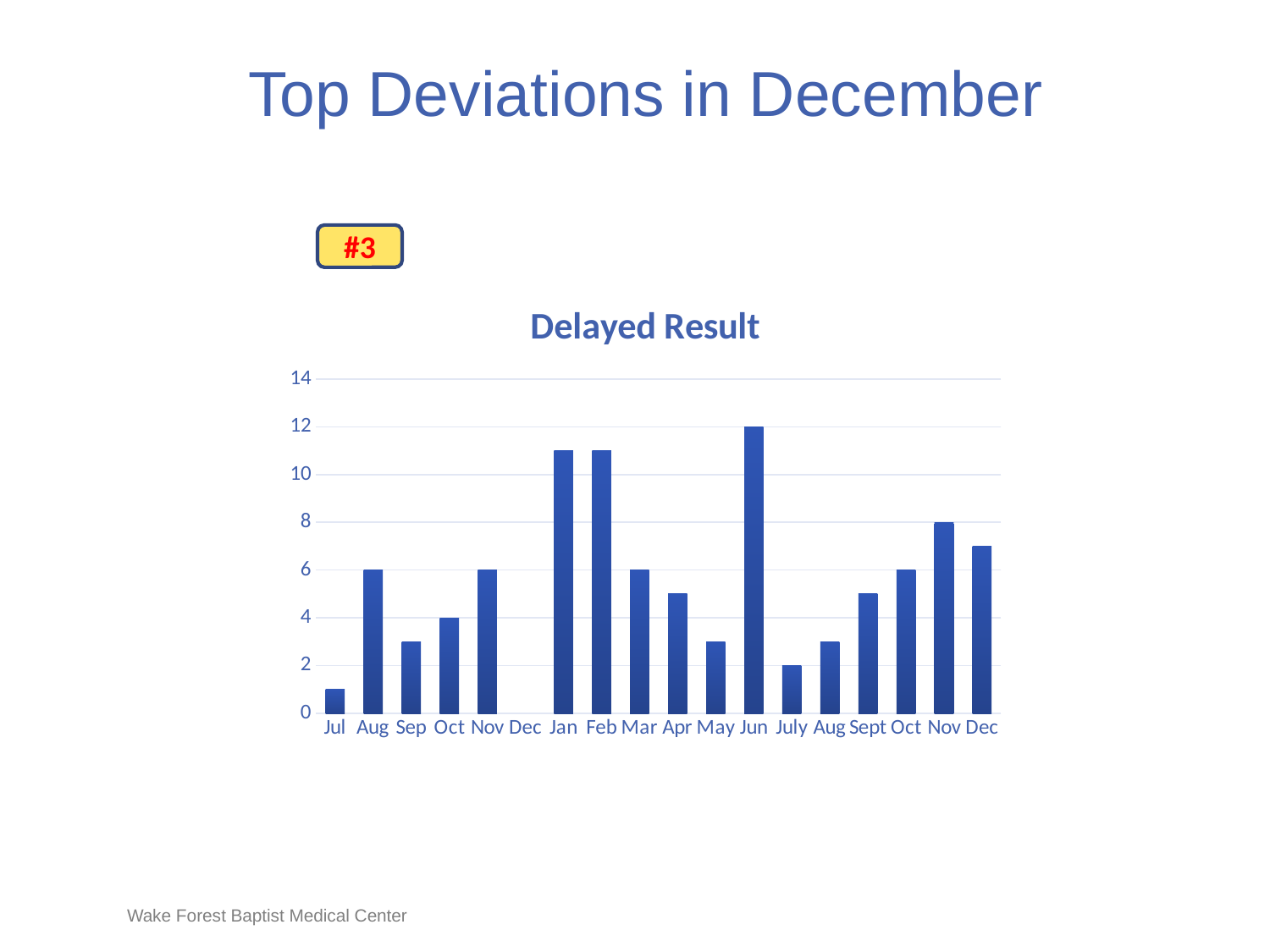
What is the value for the second Nov on the x axis? 8 What is the value for July? 2 What is the value for Jun? 12 What is the difference between the value for Jun and the value for the second Nov? 4 What type of chart is shown on the slide? bar chart Which month has the highest value in the chart? Jun What is the value for the first Oct on the x axis? 4 How many months are shown along the x axis of the chart? 18 Which is larger, the value for Feb or the value for Mar? Feb Is the value for Jul greater or less than 2? less What is the title of the chart? Delayed Result Is the value for Jan greater or less than 10? greater